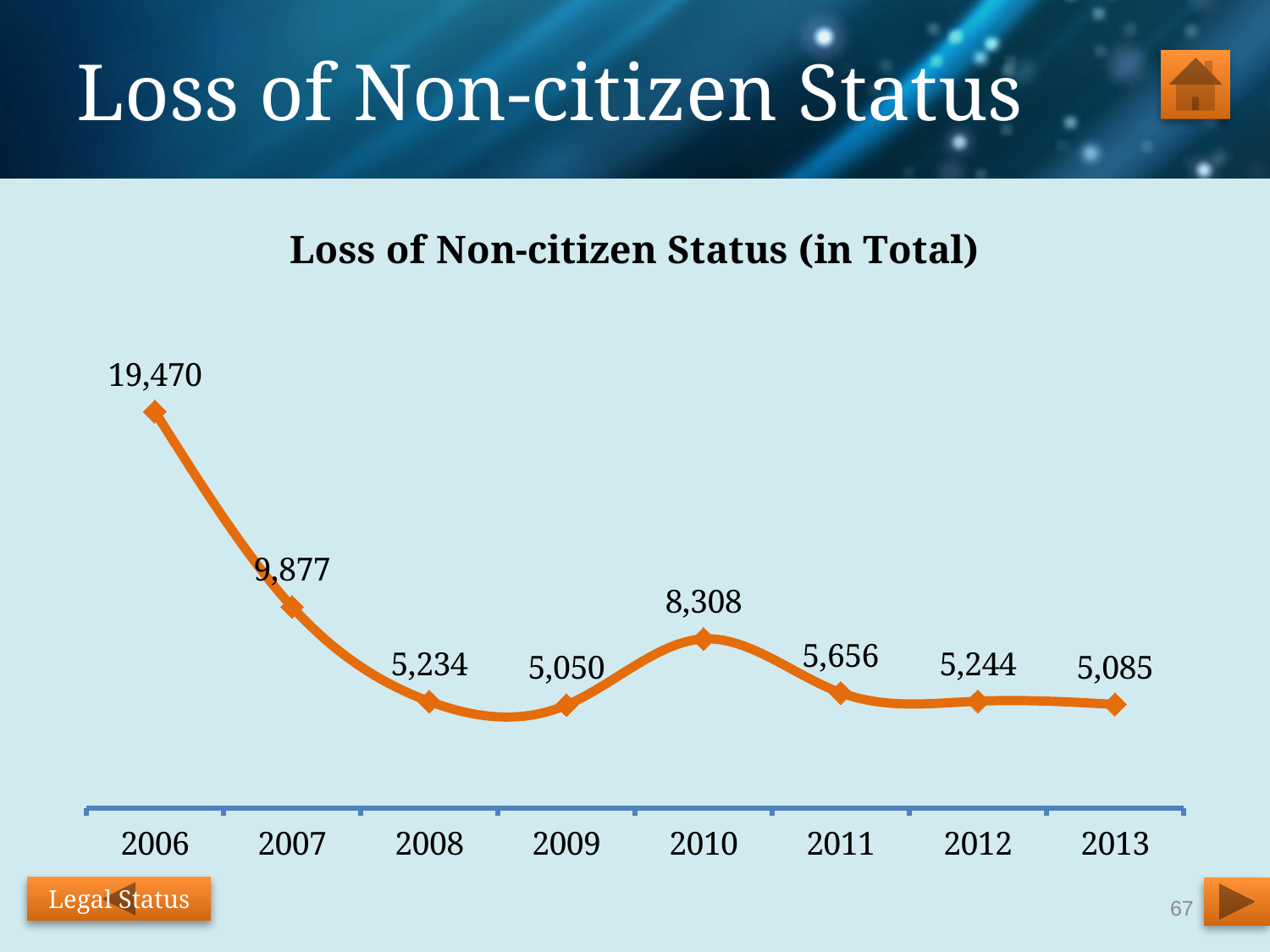
Which year has the highest value? 2006 What kind of chart is shown? line chart What is the value for 2010? 8,308 Which year has the lowest value? 2009 What is the title of the chart? Loss of Non-citizen Status (in Total) What is the difference between the values for 2006 and 2007? 9,593 Which is larger, the value for 2008 or the value for 2012? 2012 What is the value for 2013? 5,085 How many years are plotted on the chart? 8 Do the values rise or fall from 2006 to 2008? fall What is the value for 2006? 19,470 What is the difference between the values for 2010 and 2011? 2,652